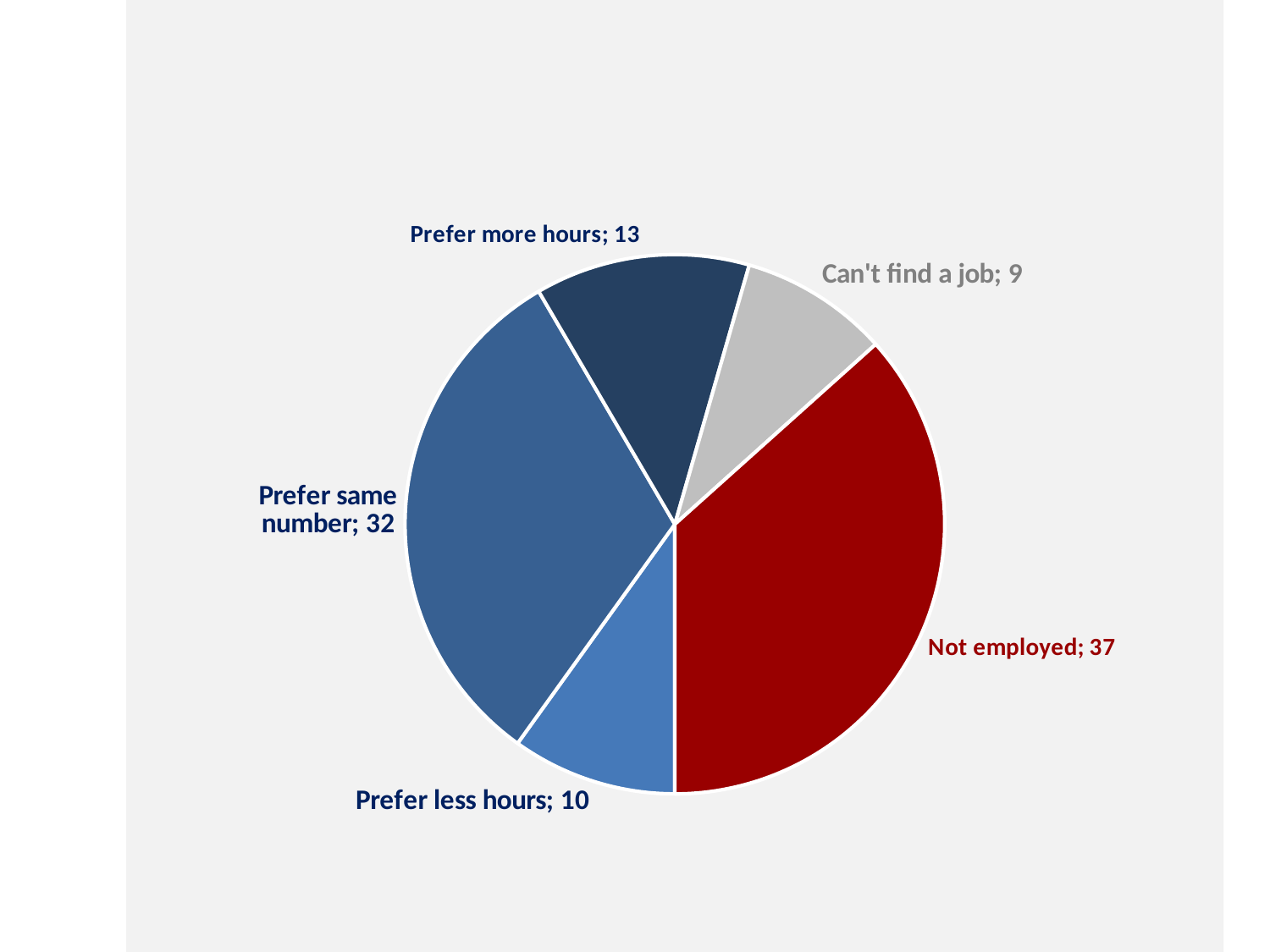
How many slices does the pie chart have? 5 What is the value for "Prefer less hours"? 10 What is the value for "Prefer same number"? 32 Which is larger, "Prefer more hours" or "Prefer less hours"? Prefer more hours What is the difference between the values for "Not employed" and "Prefer same number"? 5 What is the value for "Can't find a job"? 9 Which category has the smallest slice? Can't find a job What colour is the "Not employed" slice? dark red What is the difference between the values for "Prefer more hours" and "Can't find a job"? 4 Which category has the largest slice? Not employed What is the value for "Not employed"? 37 What kind of chart is shown on the slide? pie chart